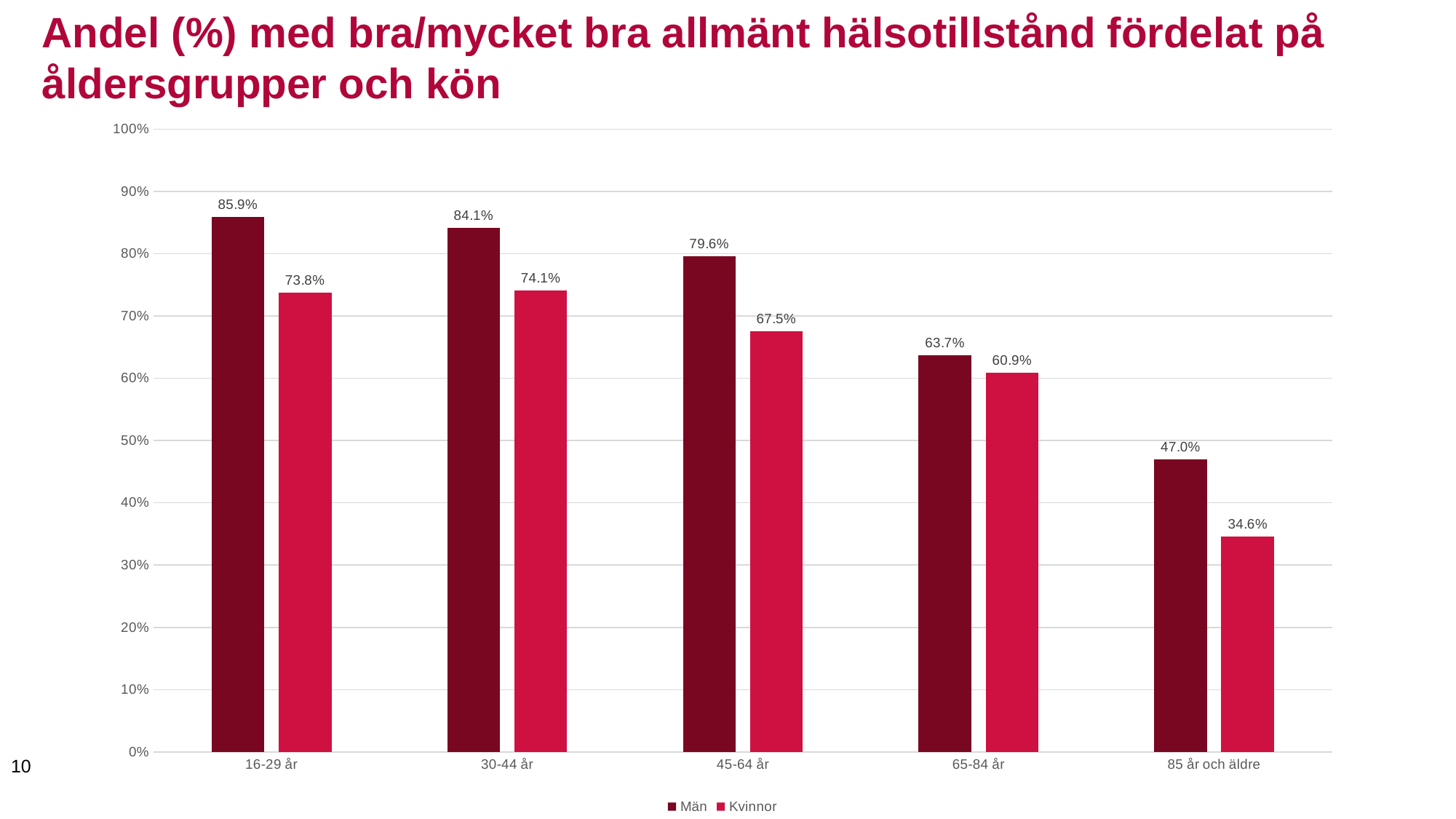
What kind of chart is shown on the slide? Bar chart Which is larger in the 30-44 år age group, Män or Kvinnor? Män Which age group has the highest value for Män? 16-29 år Which age group has the lowest value for Kvinnor? 85 år och äldre What is the difference between Män and Kvinnor in the 85 år och äldre age group? 12.4% How many age groups are shown on the x axis? 5 How many series does the legend list? 2 What is the value for Kvinnor in the 45-64 år age group? 67.5% What is the value for Män in the 16-29 år age group? 85.9% What is the difference between Män and Kvinnor in the 65-84 år age group? 2.8% What is the value for Kvinnor in the 85 år och äldre age group? 34.6%